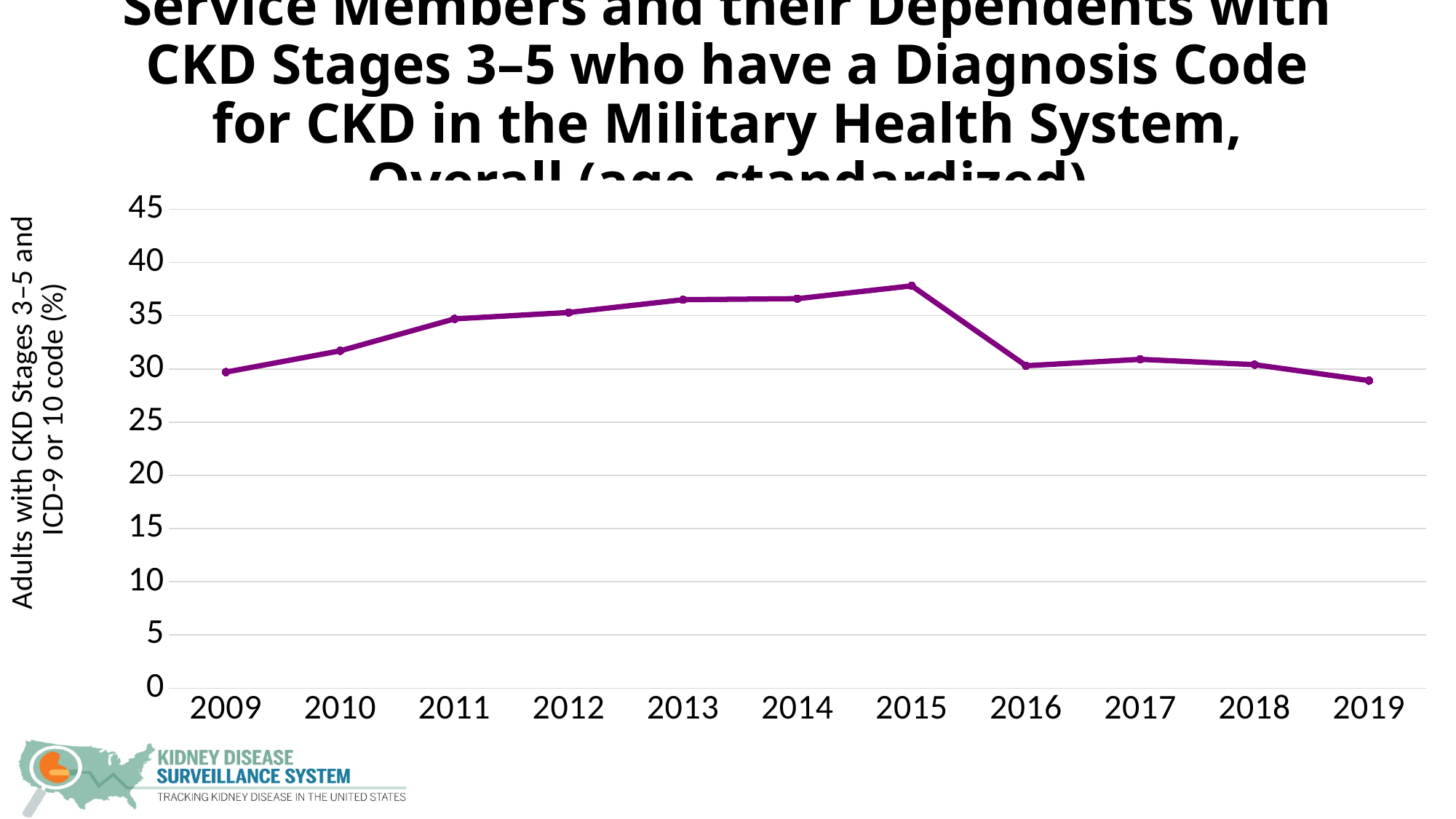
Is the value for 2010 greater or less than 30? greater Is the value for 2019 greater or less than 30? less Does the value rise or fall from 2009 to 2015? rise Is the value for 2016 greater or less than 35? less Which year has the highest value? 2015 What is the label on the y axis? Adults with CKD Stages 3–5 and ICD-9 or 10 code (%) What kind of chart is shown on the slide? line chart Which is larger, the value for 2010 or the value for 2011? 2011 Which is larger, the value for 2015 or the value for 2016? 2015 How many years are plotted on the x axis? 11